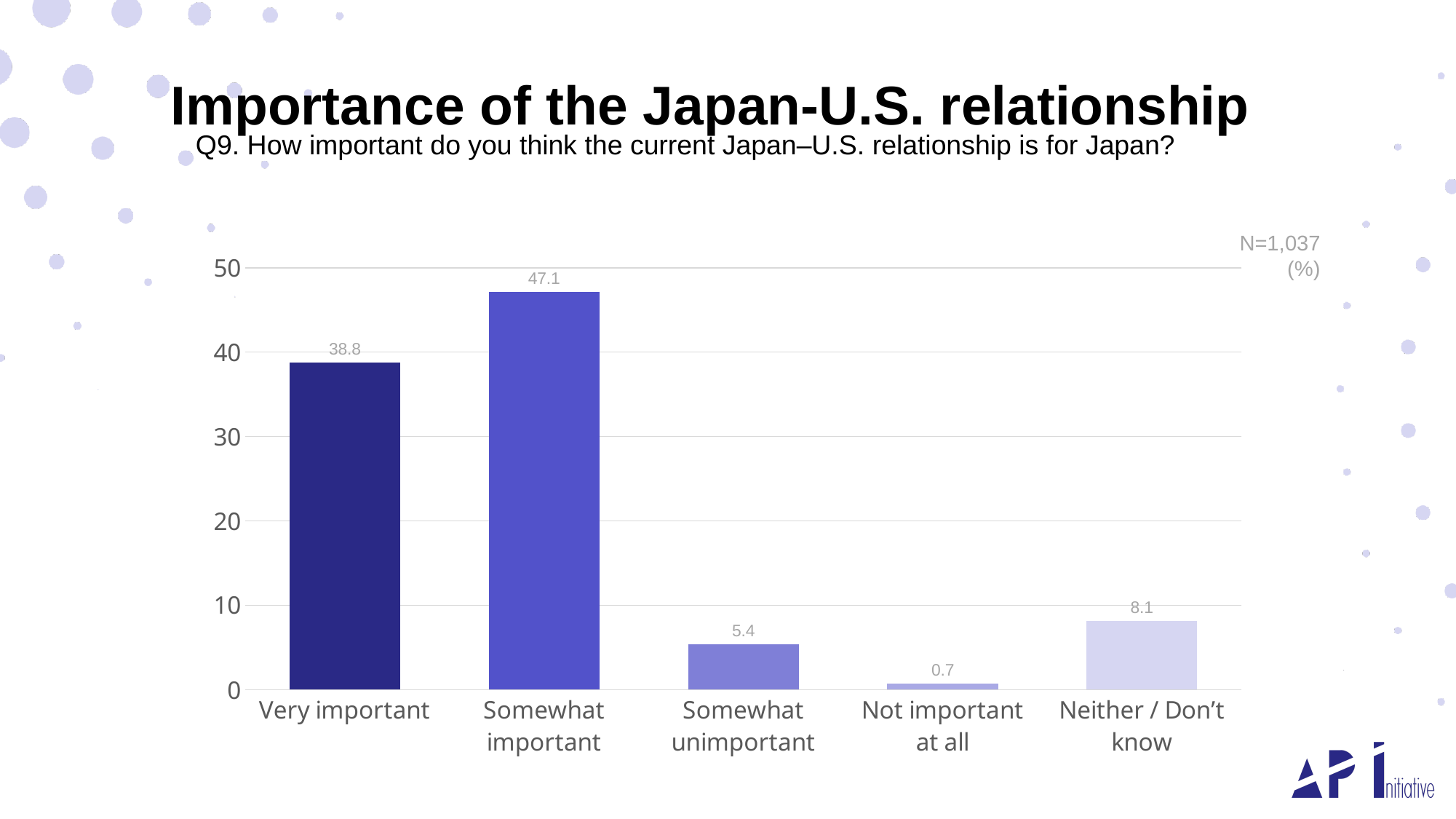
What is the difference between the values for "Somewhat important" and "Very important"? 8.3 What is the value for "Somewhat important"? 47.1 Which category has the highest value? Somewhat important Which is larger, the value for "Neither / Don't know" or the value for "Somewhat unimportant"? Neither / Don't know What is the value for "Very important"? 38.8 How many categories are shown on the x axis? 5 What kind of chart is shown on the slide? Bar chart What sample size (N) is noted on the chart? N=1,037 What is the value for "Somewhat unimportant"? 5.4 Which category has the lowest value? Not important at all What is the value for "Neither / Don't know"? 8.1 What is the value for "Not important at all"? 0.7